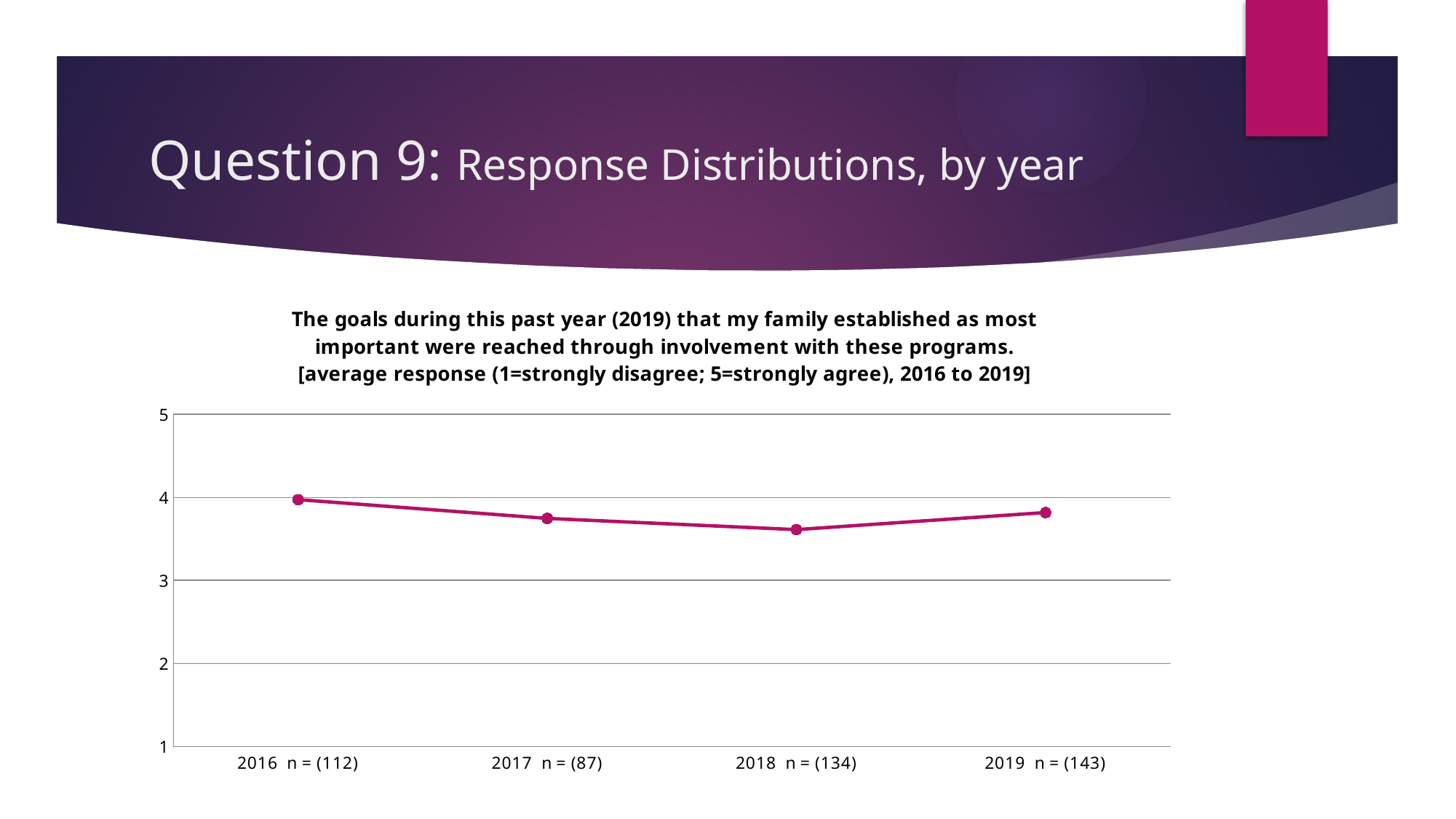
Which year has the lowest average response? 2018 Which year has a higher average response, 2016 or 2018? 2016 What is the highest value shown on the y axis? 5 Is the average response for 2017 greater or less than 3? greater Does the average response rise or fall from 2016 to 2018? fall What kind of chart is shown on the slide? line chart Is the average response for 2018 greater or less than 4? less Is the average response for 2019 greater or less than 4? less Does the average response rise or fall from 2018 to 2019? rise What sample size (n) is shown for 2017 on the x axis? 87 Which year has the highest average response? 2016 How many years (data points) are plotted on the chart? 4